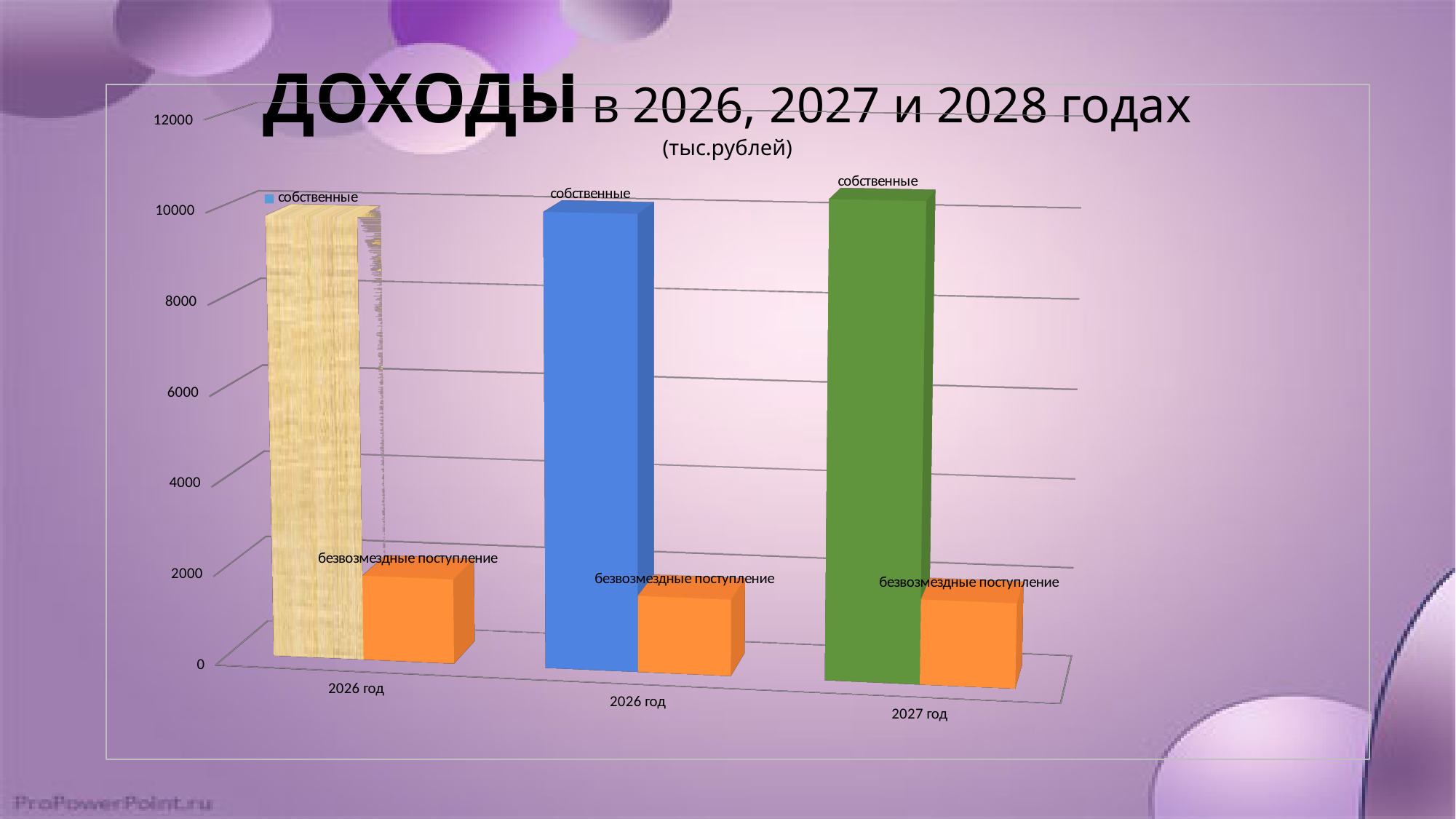
Which series has the lowest bar in the rightmost group (2027 год)? безвозмездные поступление What unit is given in the chart title? тыс.рублей Is the value of собственные in the 2027 год group greater or less than 12000? less How many category groups are shown along the x axis? 3 Which series has the highest bar in the middle group? собственные Is the value of безвозмездные поступление in the 2027 год group greater or less than 4000? less What kind of chart is shown on the slide? bar chart In the 2027 год group, which is larger: собственные or безвозмездные поступление? собственные What is the x-axis label of the rightmost group of bars? 2027 год Is the value of собственные in the first group (2026 год) greater or less than 8000? greater How many bars are plotted in total on the chart? 6